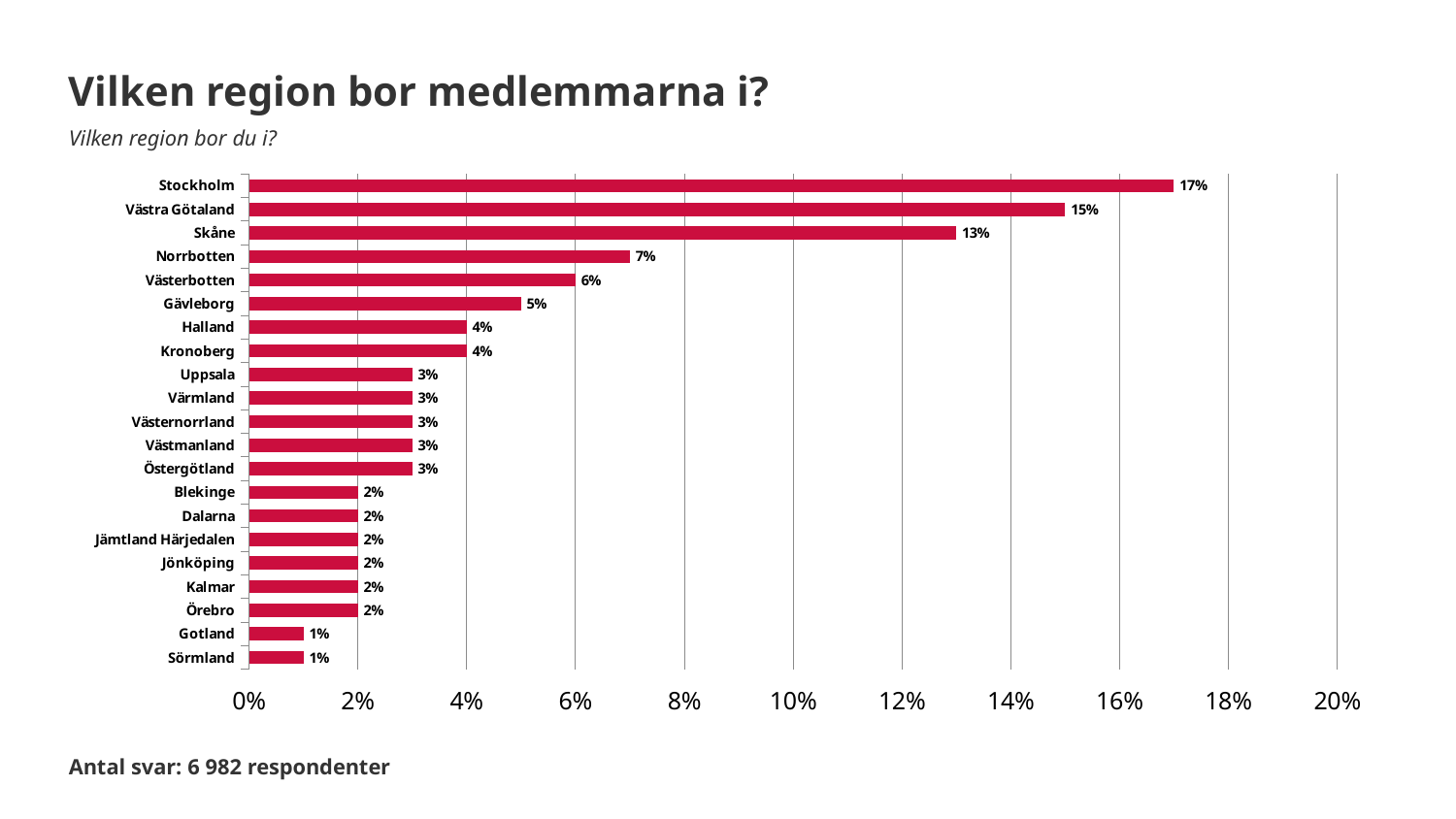
What is the value for Gävleborg? 5% What is the value shown for Skåne? 13% What is the difference between the values for Stockholm and Västra Götaland? 2% What is the title of the slide? Vilken region bor medlemmarna i? How many regions are shown in the chart? 21 Which region has the highest share of members? Stockholm What is the difference between the values for Skåne and Norrbotten? 6% What kind of chart is shown on the slide? Bar chart What percentage is shown for Norrbotten? 7% Which has a larger value, Västerbotten or Halland? Västerbotten Which has a larger value, Västra Götaland or Skåne? Västra Götaland What percentage of members live in Stockholm? 17%